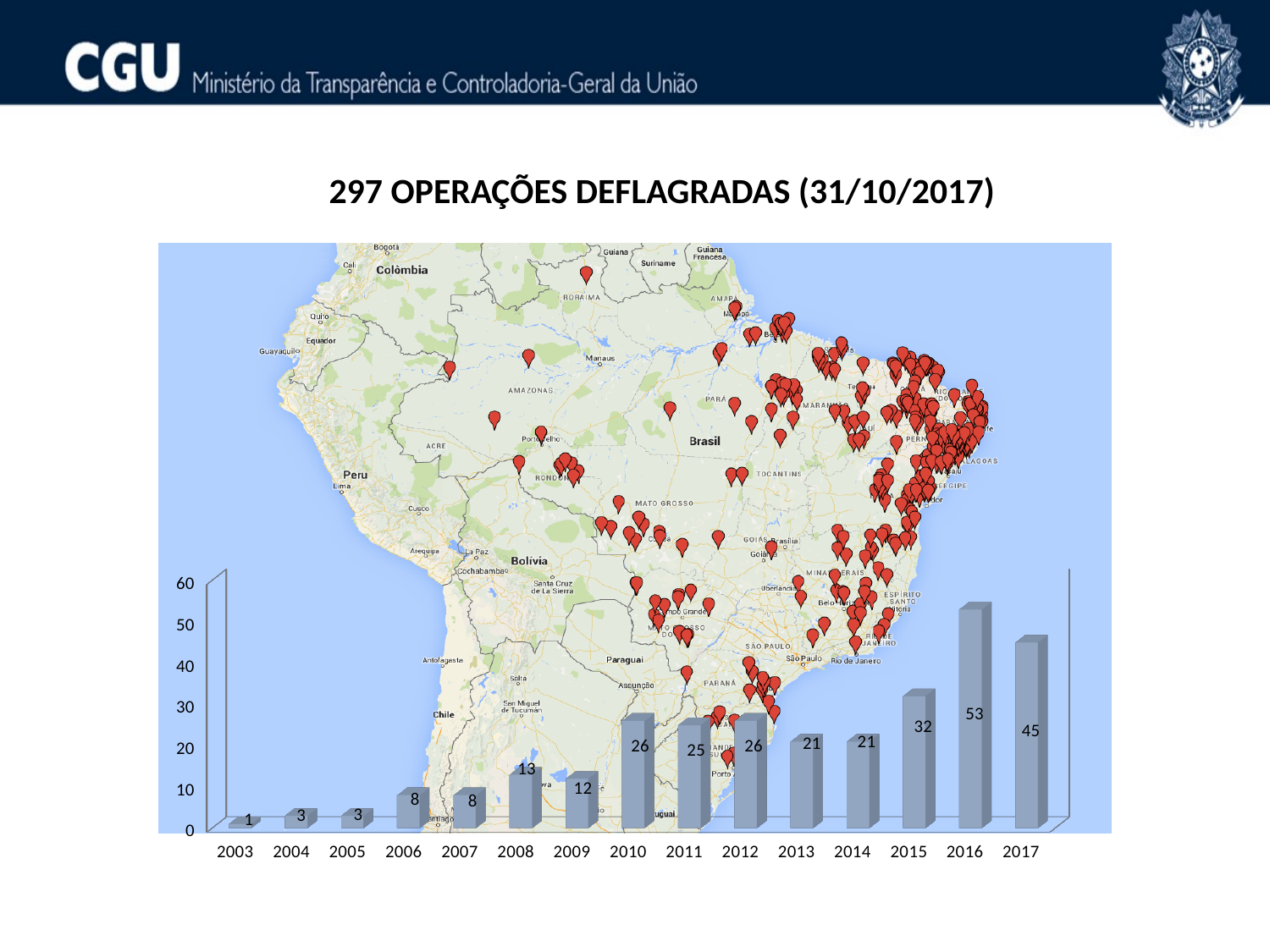
What is the value for 2010? 26 What is the difference between the values for 2016 and 2017? 8 How many years are shown on the x axis? 15 What is the difference between the values for 2009 and 2008? 1 Which year has the lowest value? 2003 What is the title of the slide above the chart? 297 OPERAÇÕES DEFLAGRADAS (31/10/2017) Which year has the highest value? 2016 What is the value for 2016? 53 Do the values generally rise or fall from 2003 to 2016? rise What kind of chart is shown on the slide? bar chart What is the value for 2003? 1 Which is larger, the value for 2015 or the value for 2014? 2015